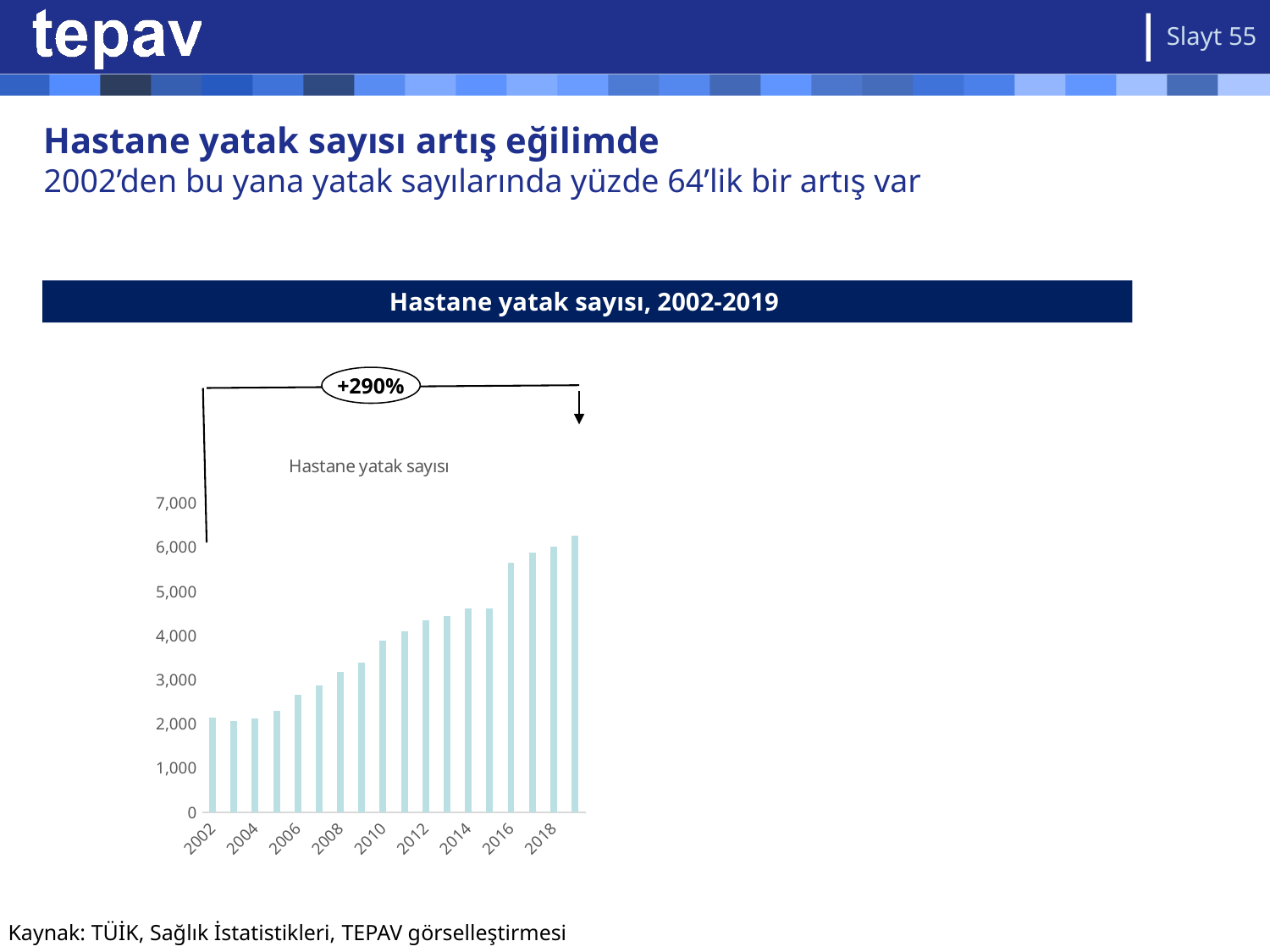
Which year has the larger value, 2010 or 2016? 2016 What percentage change is shown in the annotation above the chart? +290% How many years (bars) are plotted in the chart? 18 Is the value for 2003 greater or less than 3,000? less Is the value for 2006 greater or less than 3,000? less Do the hospital bed counts generally rise or fall from 2002 to 2019? rise Is the value for 2016 greater or less than 5,000? greater Which year has the highest hospital bed count in the chart? 2019 What kind of chart is shown on the slide? bar chart What is the title shown in the dark banner above the chart? Hastane yatak sayısı, 2002-2019